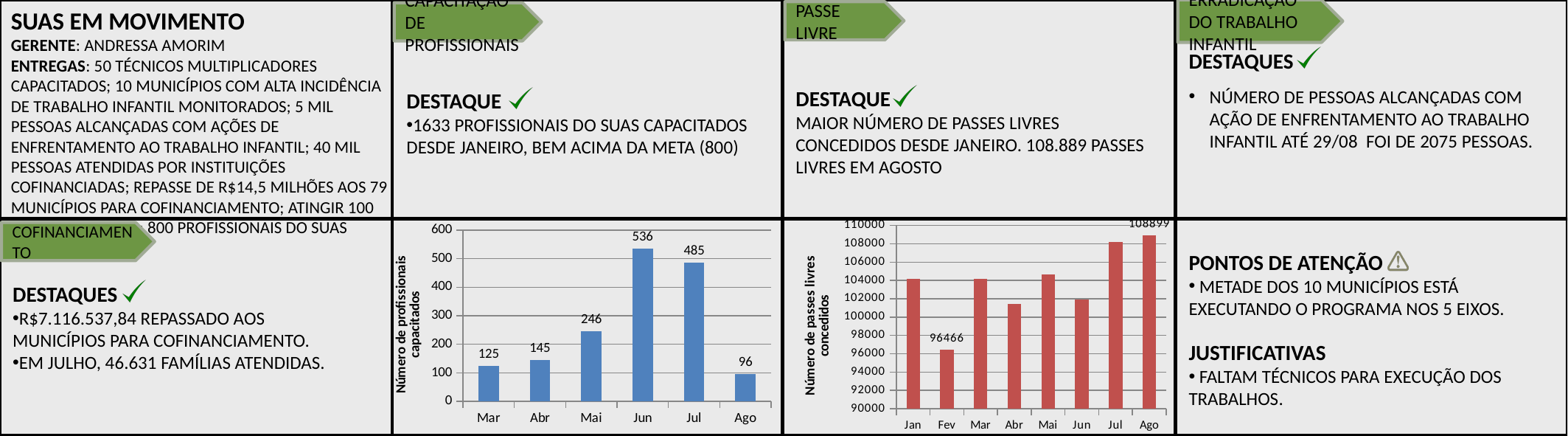
In the left chart (Número de profissionais capacitados), what is the difference between Jun and Jul? 51 In the left chart (Número de profissionais capacitados), which month has the lowest value? Ago In the right chart (Número de passes livres concedidos), is the value for Abr greater or less than 100000? greater In the left chart (Número de profissionais capacitados), what is the value for Jun? 536 In the right chart (Número de passes livres concedidos), what is the value for Fev? 96466 In the right chart (Número de passes livres concedidos), which month has the lowest value? Fev In the right chart (Número de passes livres concedidos), what is the value for Ago? 108899 In the left chart (Número de profissionais capacitados), which is larger, Mai or Abr? Mai In the left chart (Número de profissionais capacitados), how many months are shown on the x axis? 6 In the left chart (Número de profissionais capacitados), which month has the highest value? Jun In the left chart (Número de profissionais capacitados), what is the value for Ago? 96 What type of chart is the left chart (Número de profissionais capacitados)? Bar chart